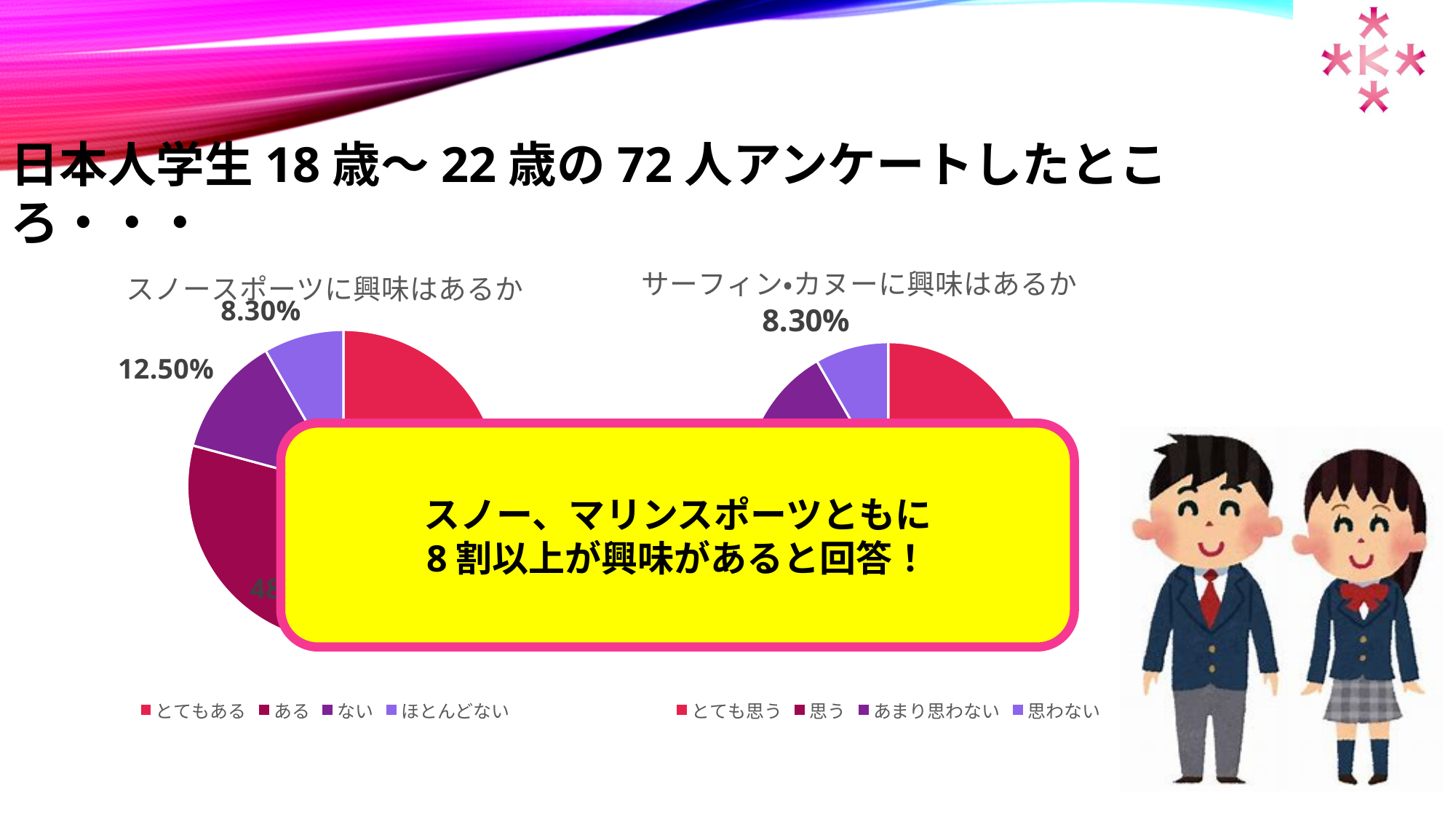
In the left chart (スノースポーツに興味はあるか), what percentage is shown for ほとんどない? 8.30% In the left chart (スノースポーツに興味はあるか), which is larger, ない or ほとんどない? ない In the right chart (サーフィン•カヌーに興味はあるか), which legend entry is shown in red? とても思う What kind of chart is the right chart titled サーフィン•カヌーに興味はあるか? pie chart How many categories does the legend of the left chart (スノースポーツに興味はあるか) list? 4 What kind of chart is the left chart titled スノースポーツに興味はあるか? pie chart In the right chart (サーフィン•カヌーに興味はあるか), what percentage is shown for 思わない? 8.30% In the left chart (スノースポーツに興味はあるか), what percentage is shown for ない? 12.50% What is the title of the left pie chart? スノースポーツに興味はあるか How many categories does the legend of the right chart (サーフィン•カヌーに興味はあるか) list? 4 In the left chart (スノースポーツに興味はあるか), what is the difference between ない and ほとんどない? 4.20%